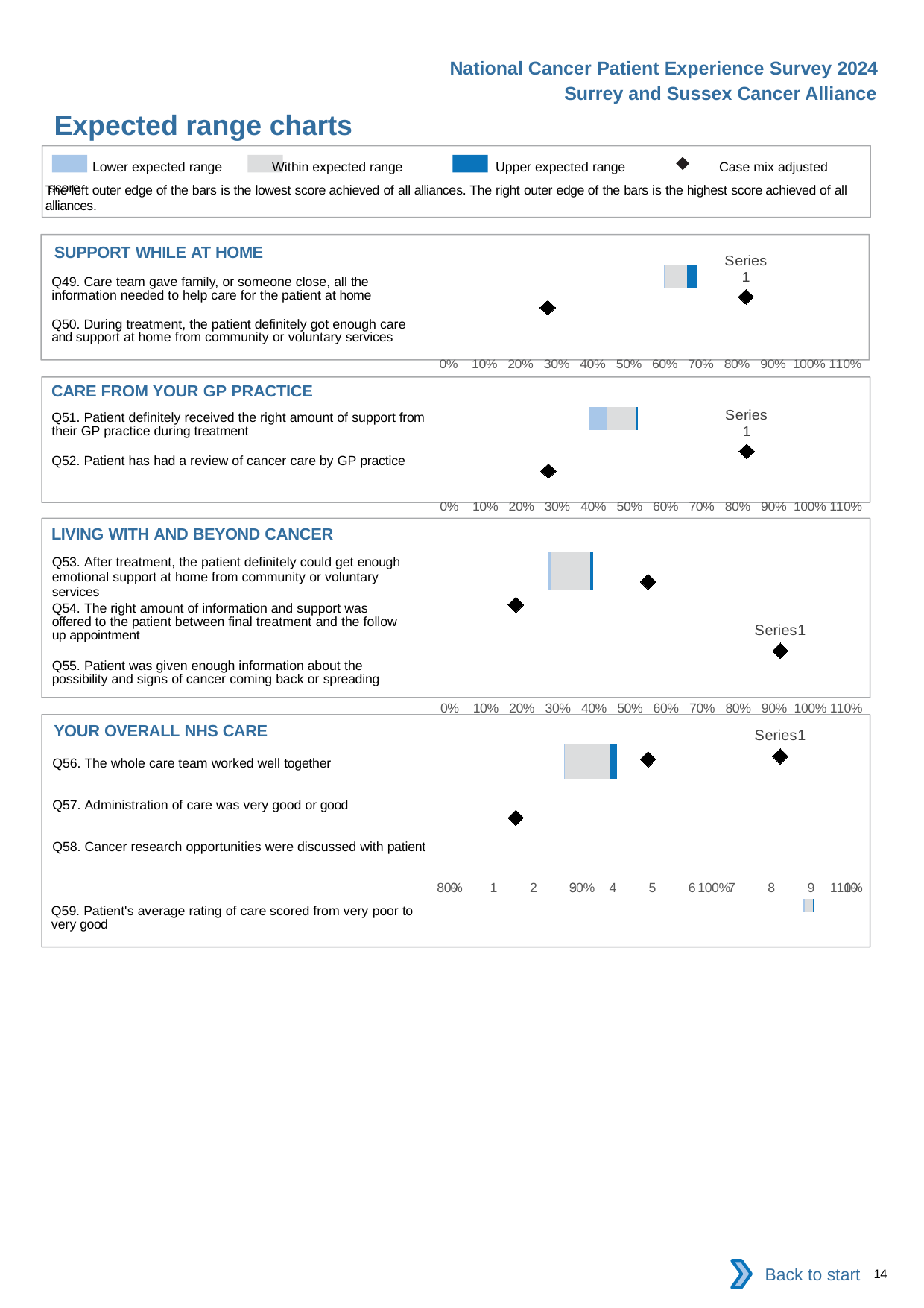
How many entries does the legend at the top of the slide list? 4 How many questions are listed in the YOUR OVERALL NHS CARE chart? 4 How many questions are listed in the SUPPORT WHILE AT HOME chart? 2 How many questions are listed in the LIVING WITH AND BEYOND CANCER chart? 3 In the CARE FROM YOUR GP PRACTICE chart, what is the highest percentage tick shown on the x axis? 110% In the LIVING WITH AND BEYOND CANCER chart, what is the lowest percentage tick shown on the x axis? 0% In the legend, what does the black diamond marker represent? Case mix adjusted score What is the title of the slide containing the charts? Expected range charts What kind of chart is used in the SUPPORT WHILE AT HOME section? Bar chart